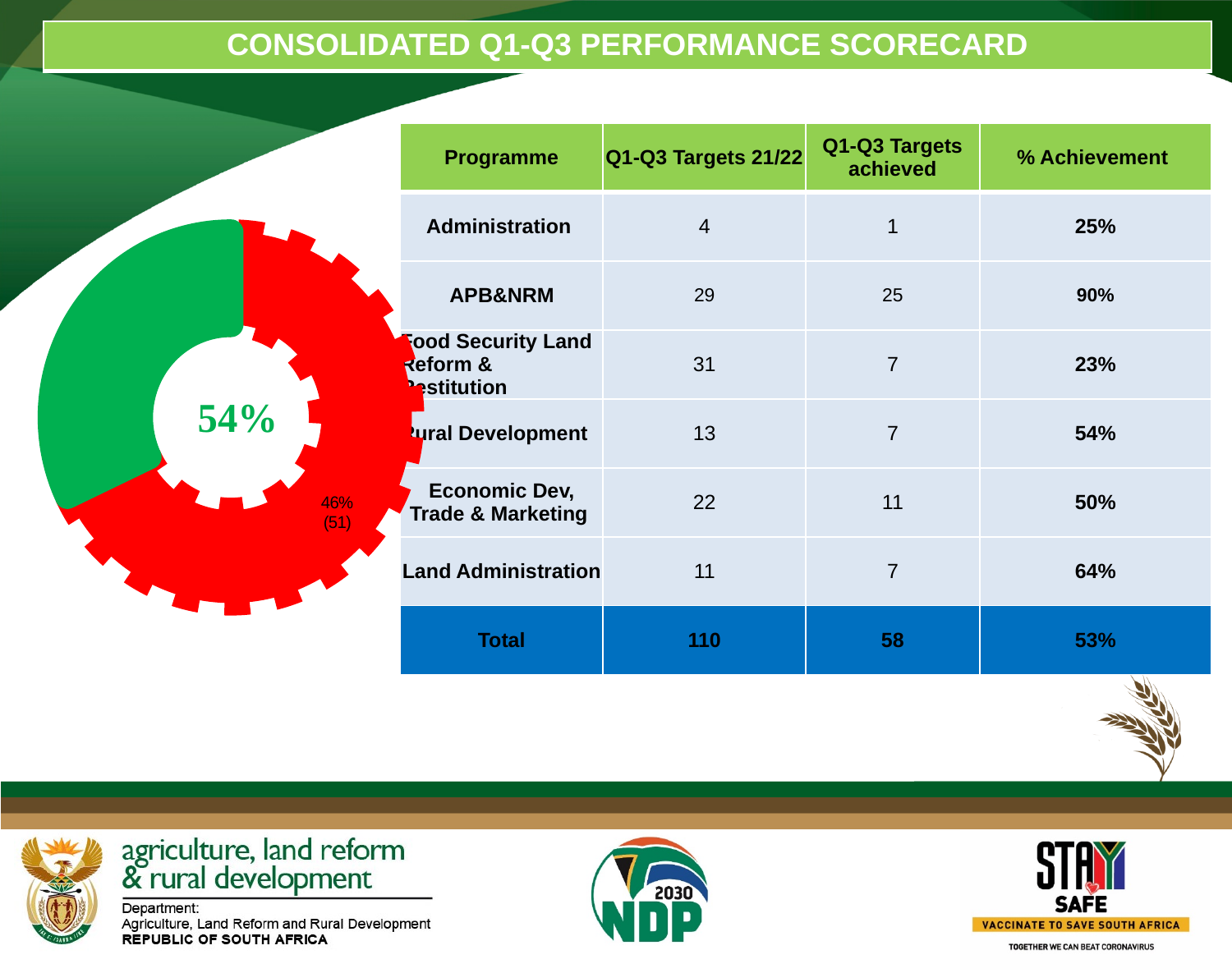
What percentage label is shown on the red slice of the doughnut chart? 46% What kind of chart is shown on the left of the slide? doughnut chart What two colours are used for the slices of the doughnut chart? green and red Which slice of the doughnut chart is larger, the red one or the green one? red How many slices does the doughnut chart on the left have? 2 What percentage is printed in the centre of the doughnut chart? 54% What number appears in parentheses under the 46% label on the red slice of the doughnut chart? 51